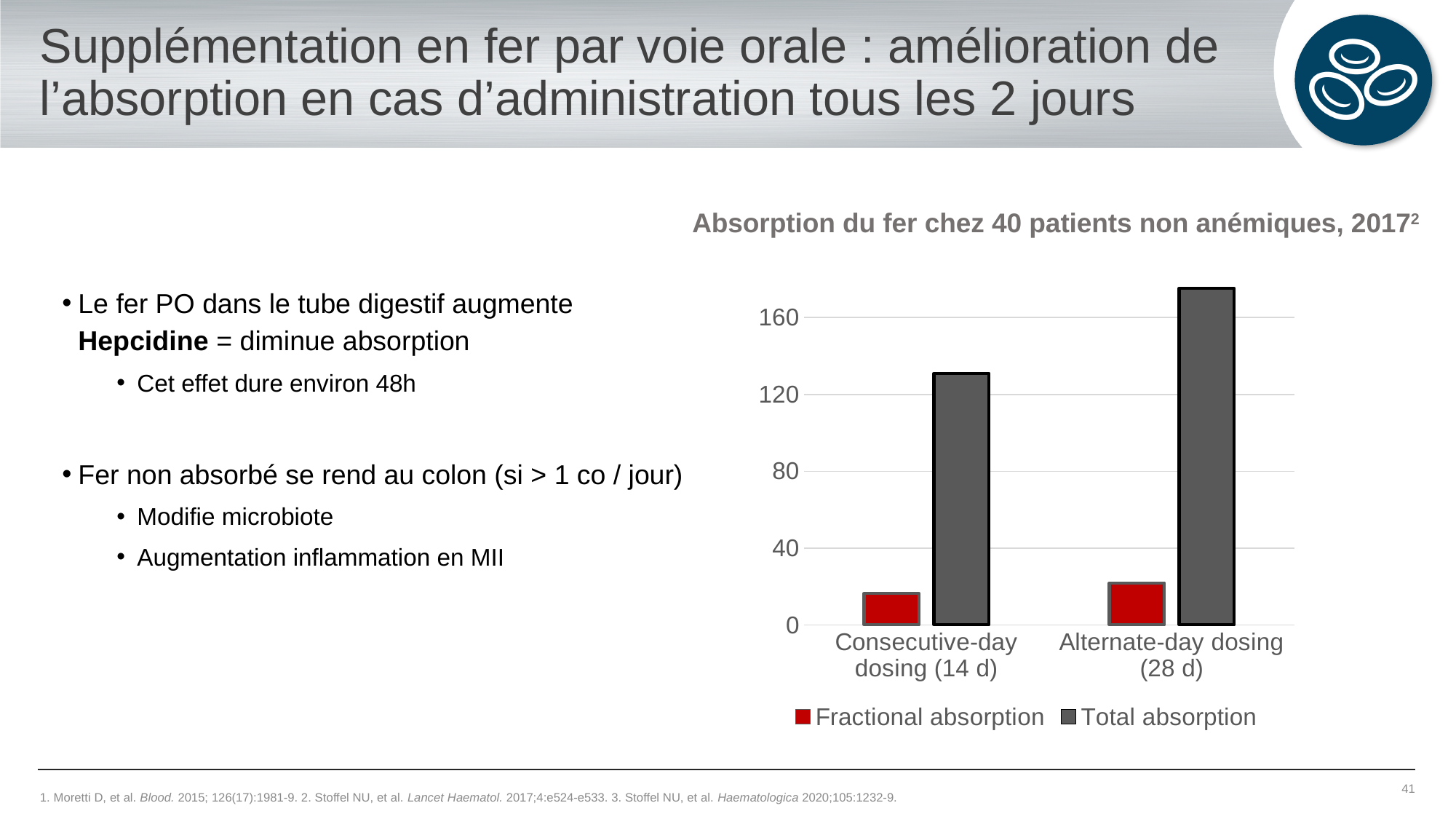
What is the title of the chart? Absorption du fer chez 40 patients non anémiques, 2017 Is the Total absorption value for Consecutive-day dosing (14 d) greater or less than 160? less How many dosing categories are shown on the x axis of the chart? 2 What kind of chart is shown on the slide? bar chart Is the Total absorption value for Consecutive-day dosing (14 d) greater or less than 120? greater How many series does the chart legend list? 2 Do the Total absorption values rise or fall from Consecutive-day dosing to Alternate-day dosing? rise Which category has the highest Total absorption bar? Alternate-day dosing (28 d) Is the Fractional absorption value for Alternate-day dosing (28 d) greater or less than 40? less Is Total absorption larger for Consecutive-day dosing (14 d) or Alternate-day dosing (28 d)? Alternate-day dosing (28 d) Which category has the lowest Fractional absorption bar? Consecutive-day dosing (14 d)